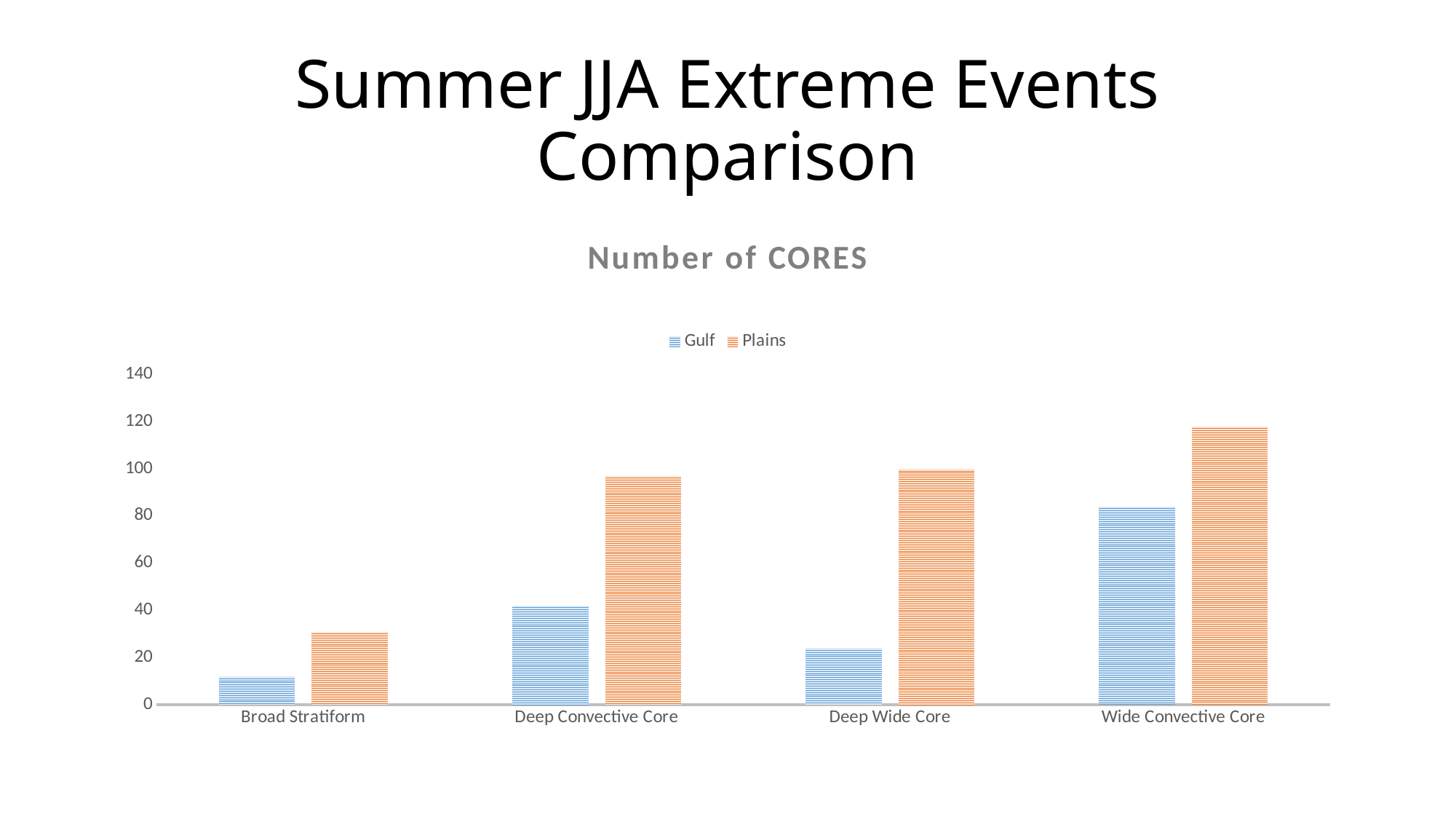
Is the Gulf value for Deep Wide Core greater or less than 40? less Which category has the highest Gulf value? Wide Convective Core Is the Plains value for Wide Convective Core greater or less than 100? greater What is the title of the chart? Number of CORES Is the Gulf value for Broad Stratiform greater or less than 20? less Which category has the highest Plains value? Wide Convective Core How many categories are shown on the x axis? 4 How many series does the legend list? 2 What kind of chart is shown on the slide? bar chart Which is larger for Gulf: Deep Convective Core or Deep Wide Core? Deep Convective Core Which category has the lowest Gulf value? Broad Stratiform